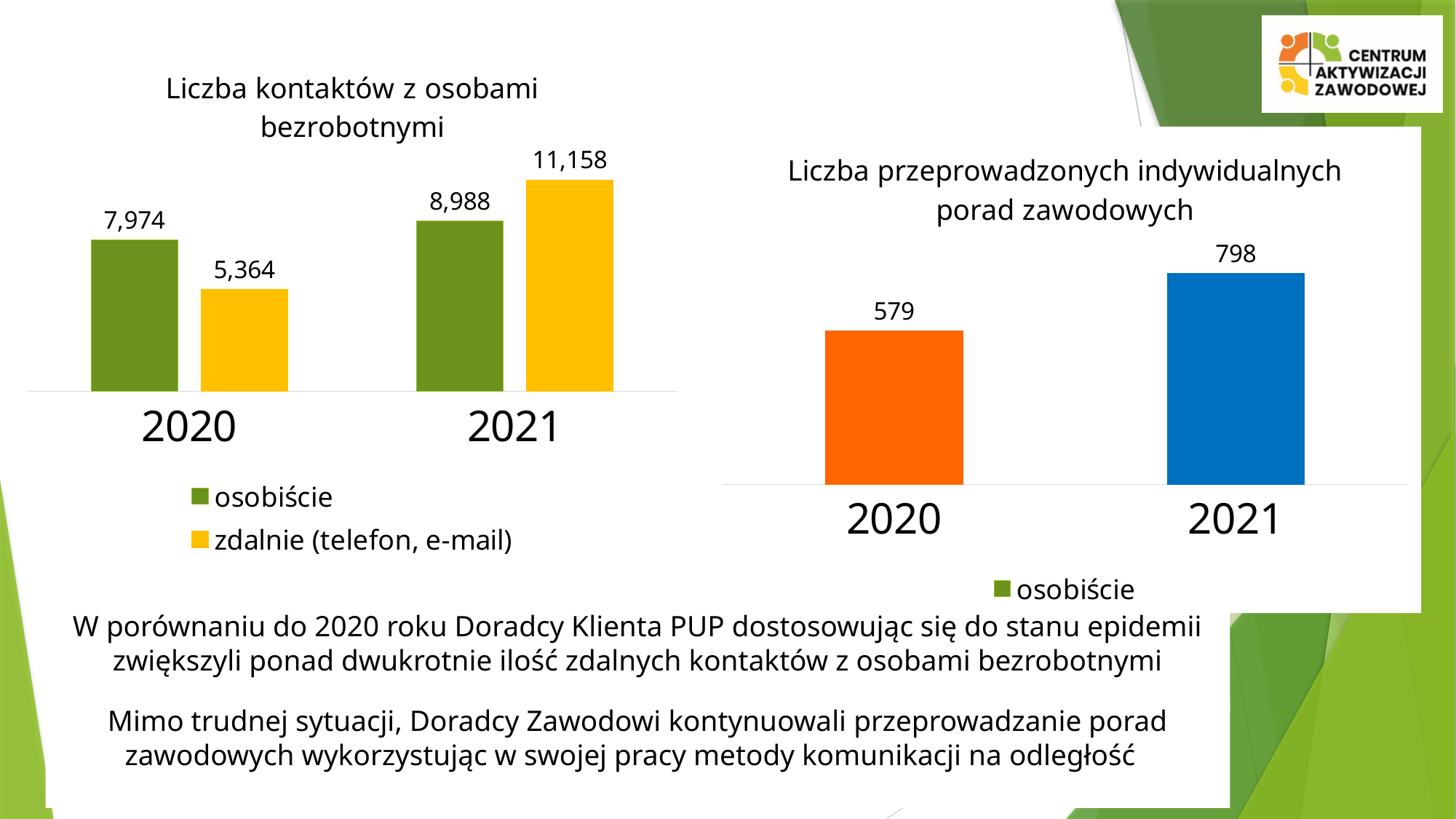
In the chart 'Liczba kontaktów z osobami bezrobotnymi', which bar is the highest? zdalnie (telefon, e-mail) in 2021 What kind of chart is 'Liczba przeprowadzonych indywidualnych porad zawodowych'? bar chart In the chart 'Liczba kontaktów z osobami bezrobotnymi', how many series does the legend list? 2 In the chart 'Liczba kontaktów z osobami bezrobotnymi', what is the difference between the 'zdalnie (telefon, e-mail)' values for 2021 and 2020? 5,794 In the chart 'Liczba kontaktów z osobami bezrobotnymi', what is the value for 'zdalnie (telefon, e-mail)' in 2021? 11,158 In the chart 'Liczba przeprowadzonych indywidualnych porad zawodowych', what is the value for 2021? 798 In the chart 'Liczba kontaktów z osobami bezrobotnymi', what is the value for 'zdalnie (telefon, e-mail)' in 2020? 5,364 In the chart 'Liczba kontaktów z osobami bezrobotnymi', which bar is the lowest? zdalnie (telefon, e-mail) in 2020 In the chart 'Liczba przeprowadzonych indywidualnych porad zawodowych', what is the difference between the 2021 and 2020 values? 219 In the chart 'Liczba przeprowadzonych indywidualnych porad zawodowych', do the values rise or fall from 2020 to 2021? rise In the chart 'Liczba kontaktów z osobami bezrobotnymi', which is larger in 2021: 'osobiście' or 'zdalnie (telefon, e-mail)'? zdalnie (telefon, e-mail) In the chart 'Liczba kontaktów z osobami bezrobotnymi', what is the value for 'osobiście' in 2020? 7,974